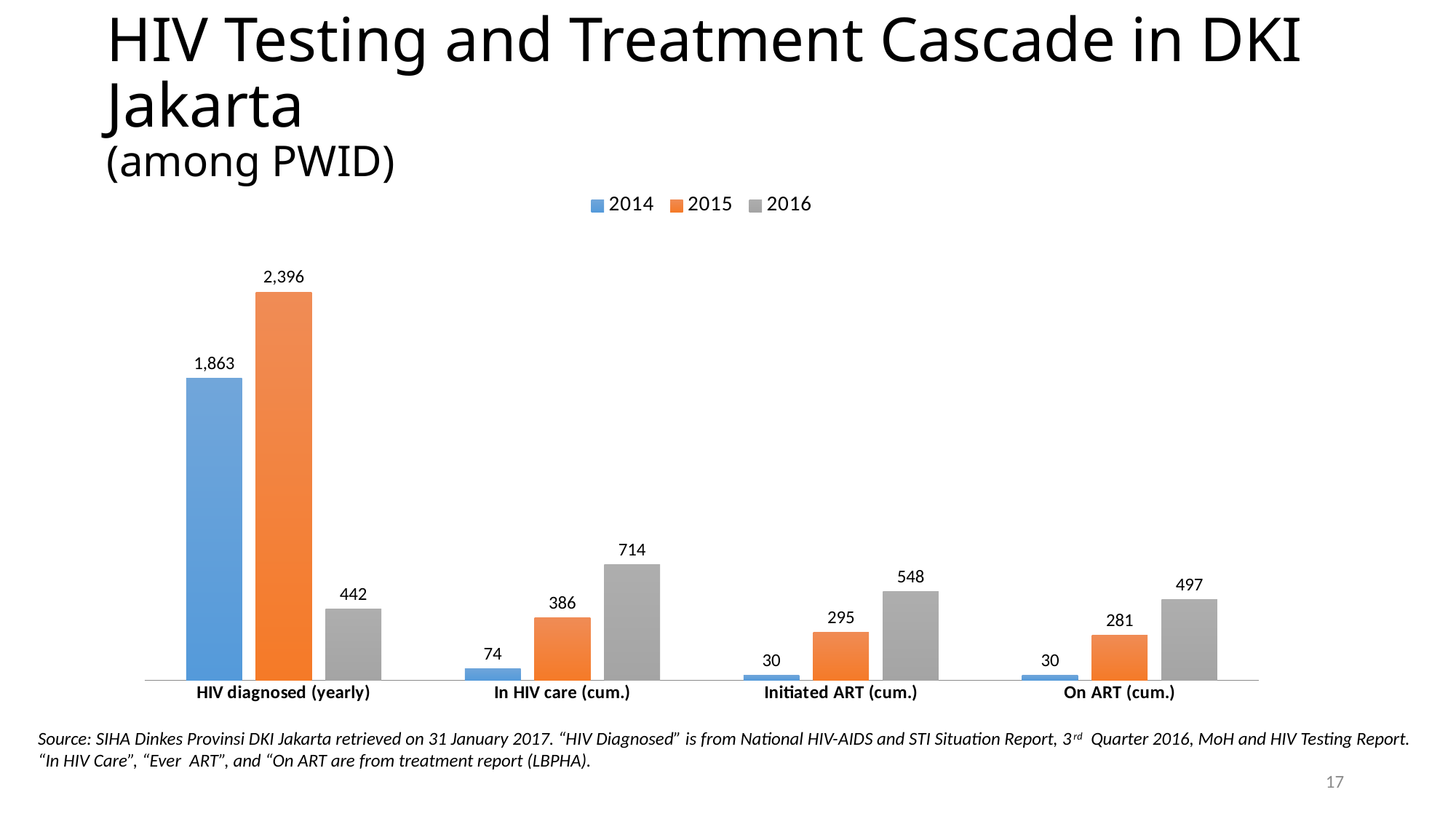
How many categories are shown on the x axis? 4 What is the 2015 value for On ART (cum.)? 281 What kind of chart is shown on the slide? Bar chart What is the 2014 value for Initiated ART (cum.)? 30 What is the difference between the 2016 and 2015 values for Initiated ART (cum.)? 253 What is the 2015 value for HIV diagnosed (yearly)? 2,396 What is the 2016 value for In HIV care (cum.)? 714 Which category has the lowest 2015 value? On ART (cum.) Which is larger for In HIV care (cum.): the 2015 value or the 2016 value? 2016 What is the difference between the 2015 and 2014 values for HIV diagnosed (yearly)? 533 Which category has the highest 2016 value? In HIV care (cum.) How many series does the legend list? 3